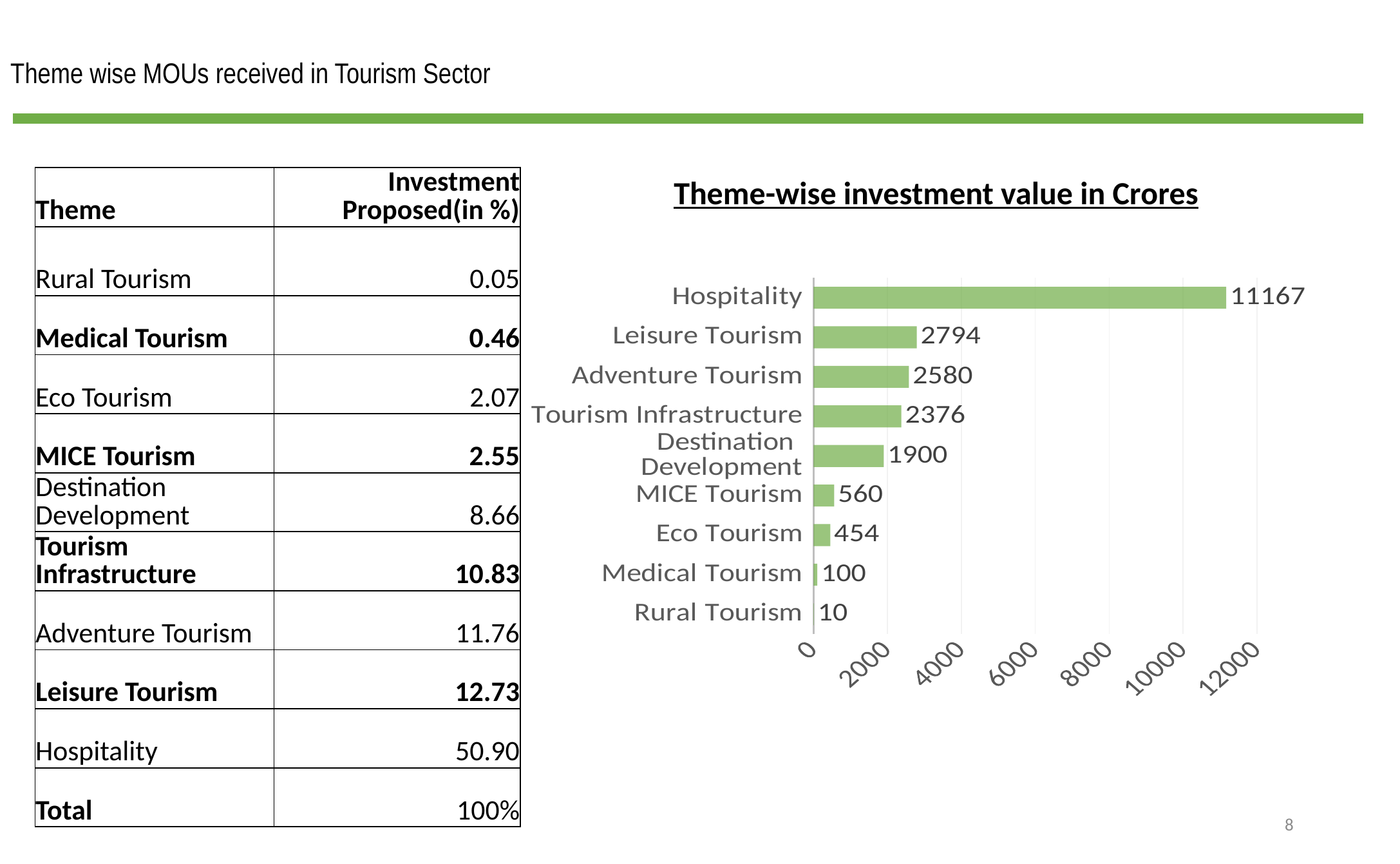
Is the investment value for MICE Tourism greater or less than 2000? less What kind of chart is shown on the slide? bar chart Which theme has the lowest investment value in the chart? Rural Tourism What is the investment value for Adventure Tourism in the chart? 2580 How many themes are shown in the chart? 9 What is the difference between the investment values for Leisure Tourism and Adventure Tourism? 214 Which has a larger investment value, Tourism Infrastructure or Destination Development? Tourism Infrastructure What is the difference between the investment values for Medical Tourism and Rural Tourism? 90 What is the investment value for Eco Tourism in the chart? 454 What is the title of the chart? Theme-wise investment value in Crores What is the investment value for Hospitality in the chart? 11167 Which theme has the highest investment value in the chart? Hospitality